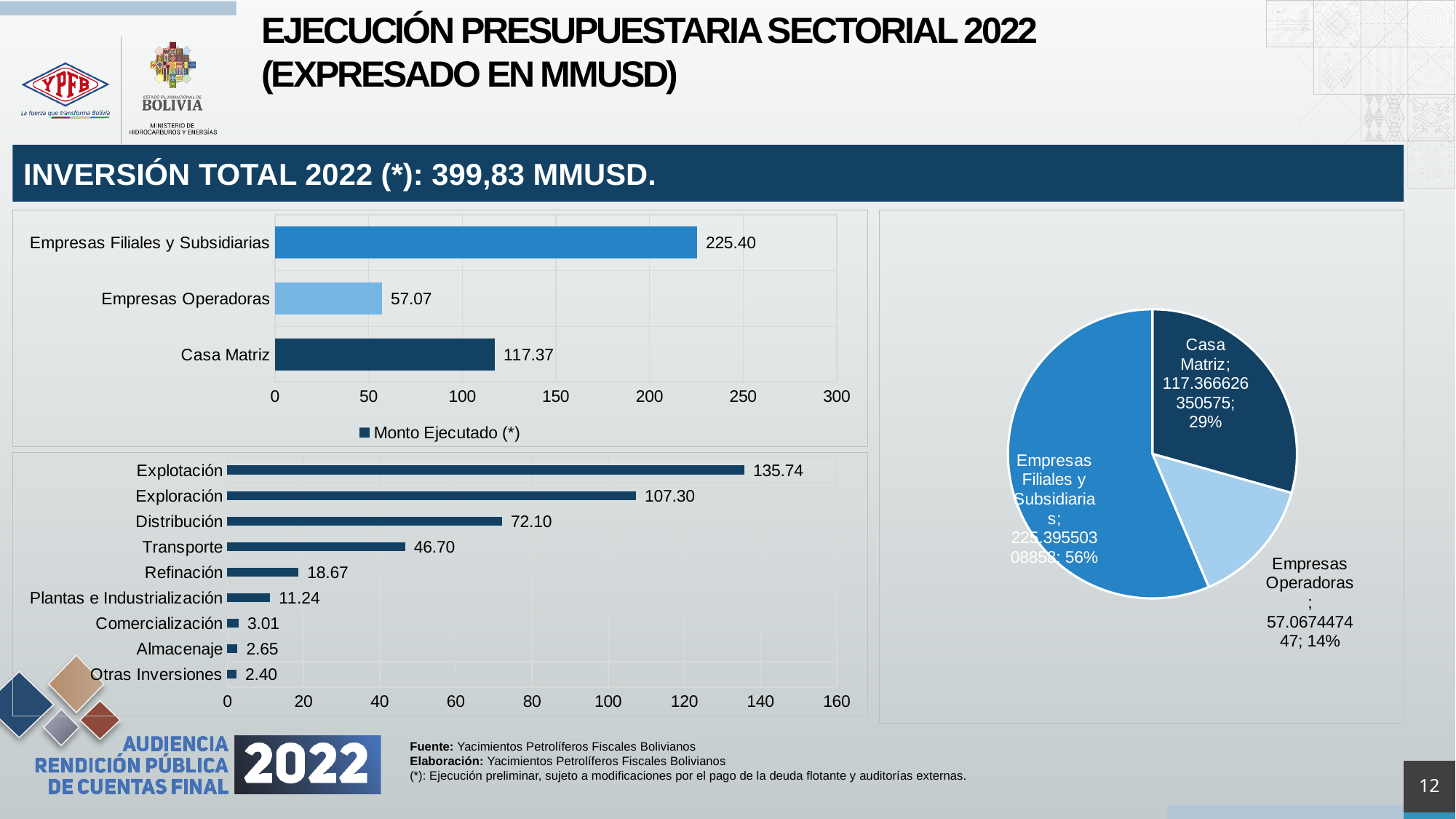
In the bottom-left bar chart, which is larger: Transporte or Refinación? Transporte How many categories are shown in the bottom-left bar chart? 9 In the top-left bar chart, what is the value for Casa Matriz? 117.37 In the pie chart on the right, what share does Empresas Operadoras have? 14% In the bottom-left bar chart, which category has the highest value? Explotación In the top-left bar chart, which category has the lowest value? Empresas Operadoras In the top-left bar chart, what is the difference between Empresas Filiales y Subsidiarias and Casa Matriz? 108.03 In the top-left bar chart, what series name does the legend show? Monto Ejecutado (*) In the top-left bar chart, what is the value for Empresas Filiales y Subsidiarias? 225.40 What type of chart is shown on the right side of the slide? Pie chart In the bottom-left bar chart, what is the value for Exploración? 107.30 In the bottom-left bar chart, which category has the lowest value? Otras Inversiones